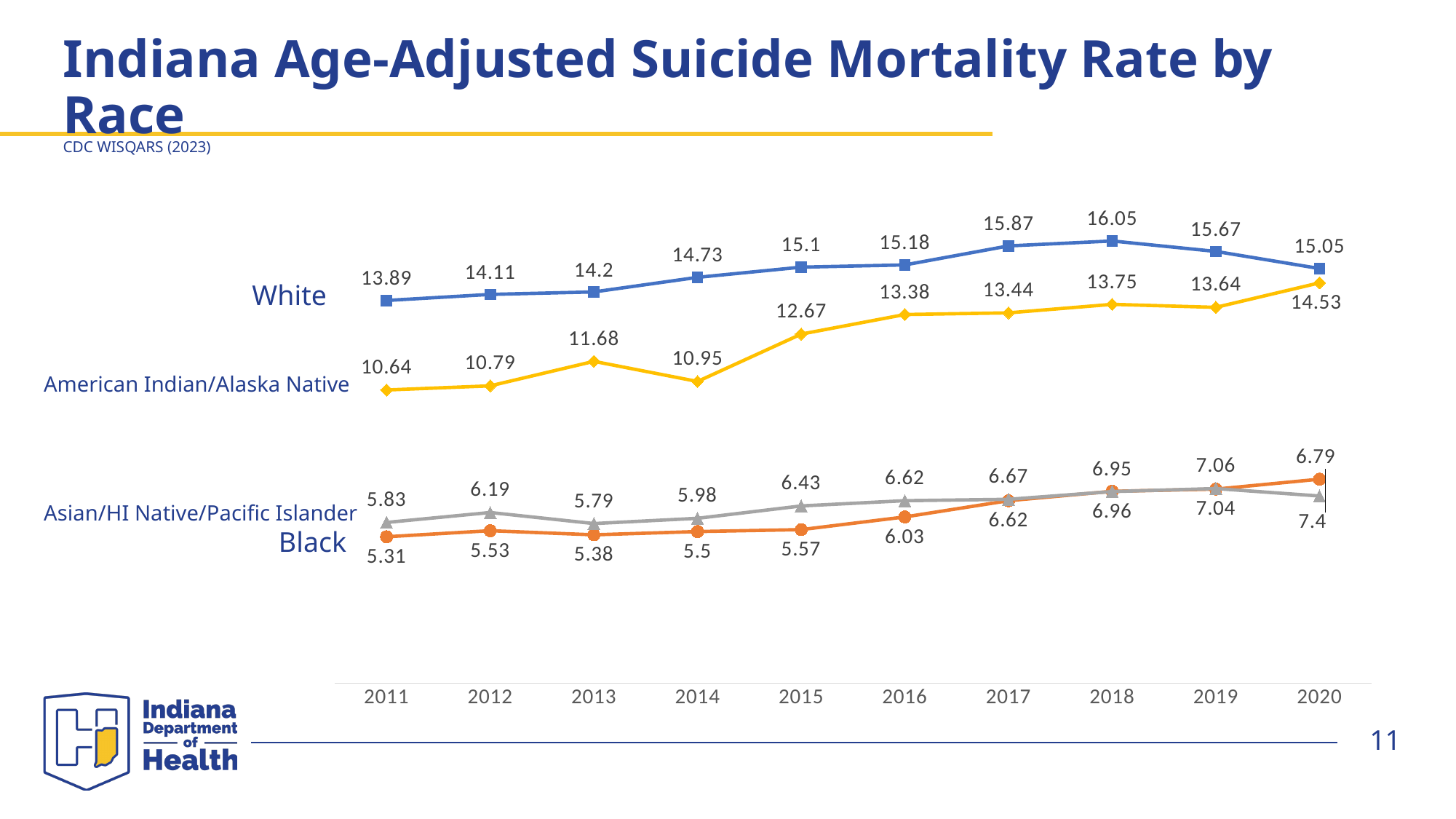
In which year was the rate for Black residents lowest? 2011 What type of chart is shown on the slide? Line chart How much higher was the White rate in 2018 than in 2011? 2.16 By how much did the American Indian/Alaska Native rate increase from 2011 to 2020? 3.89 What was the rate for Black residents in 2011? 5.31 In 2014, which group had the higher rate: White or American Indian/Alaska Native? White What was the age-adjusted suicide mortality rate for White Indiana residents in 2011? 13.89 What was the rate for American Indian/Alaska Native residents in 2015? 12.67 How many years are shown on the x axis? 10 How many racial groups (series) are plotted on the chart? 4 What was the rate for Asian/HI Native/Pacific Islander residents in 2012? 6.19 In which year did the White series reach its highest value? 2018